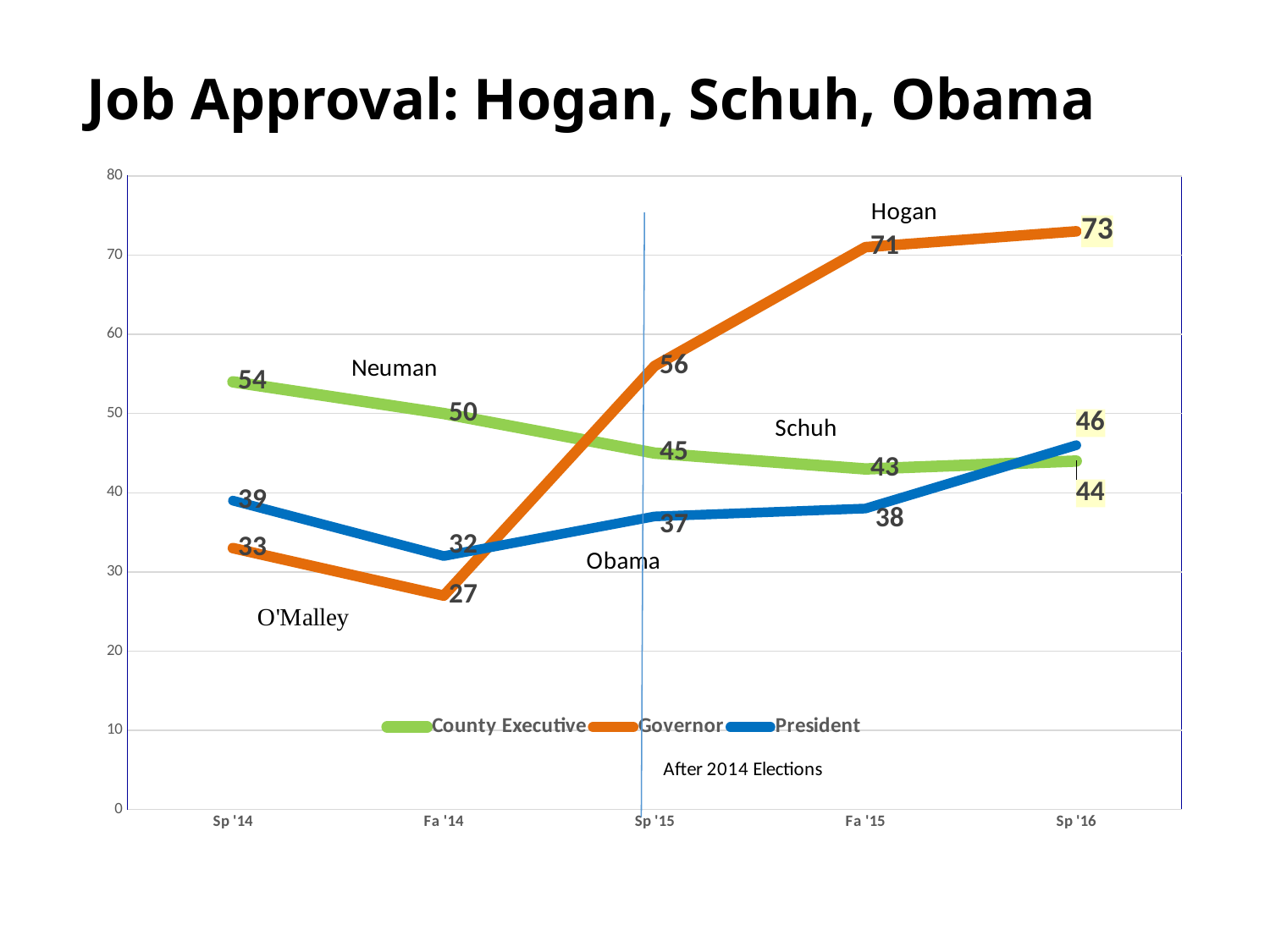
At which time point is the President series highest? Sp '16 How many time points are shown on the x axis? 5 What is the difference between the Governor value at Sp '16 and the Governor value at Sp '14? 40 What is the County Executive job approval value at Sp '14? 54 Which series has the larger value at Sp '15, Governor or County Executive? Governor Is the Governor value at Fa '15 greater or less than 60? greater What kind of chart is shown on the slide? line chart What is the President job approval value at Fa '14? 32 Does the County Executive series rise or fall from Sp '14 to Fa '15? fall How many series does the legend list? 3 What is the Governor job approval value at Sp '16? 73 At which time point is the Governor series lowest? Fa '14